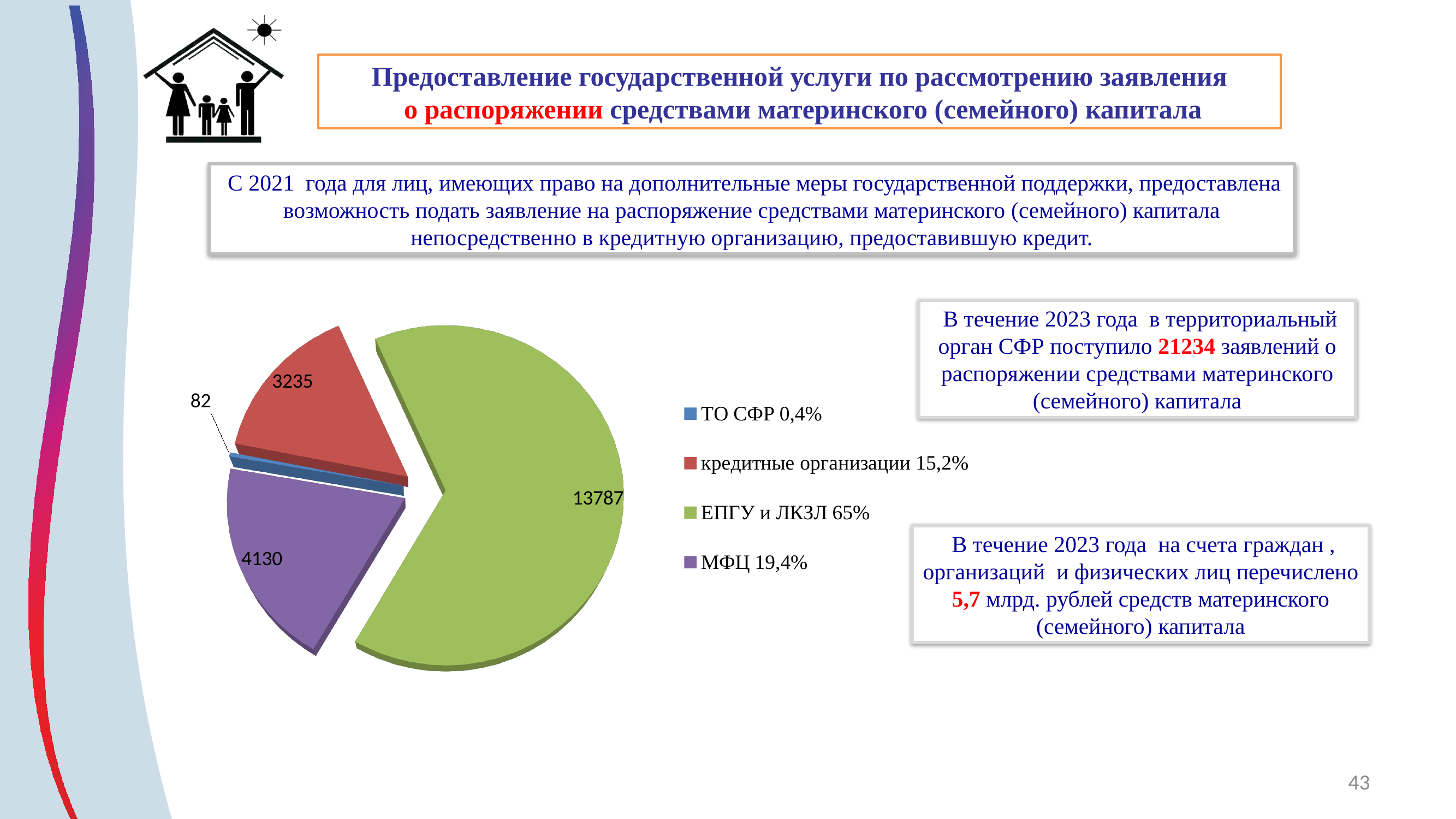
Which is larger: the value for МФЦ or the value for кредитные организации? МФЦ Which category has the smallest slice of the pie? ТО СФР What is the value shown for the ТО СФР slice? 82 What is the value shown for the ЕПГУ и ЛКЗЛ slice? 13787 What is the value shown for the кредитные организации slice? 3235 Which category has the largest slice of the pie? ЕПГУ и ЛКЗЛ What is the difference between the МФЦ value and the кредитные организации value? 895 What is the value shown for the МФЦ slice? 4130 What share of the pie does the МФЦ slice represent, according to the legend? 19,4% How many slices does the pie chart have? 4 What share of the pie does the кредитные организации slice represent, according to the legend? 15,2% What kind of chart is shown on the slide? pie chart